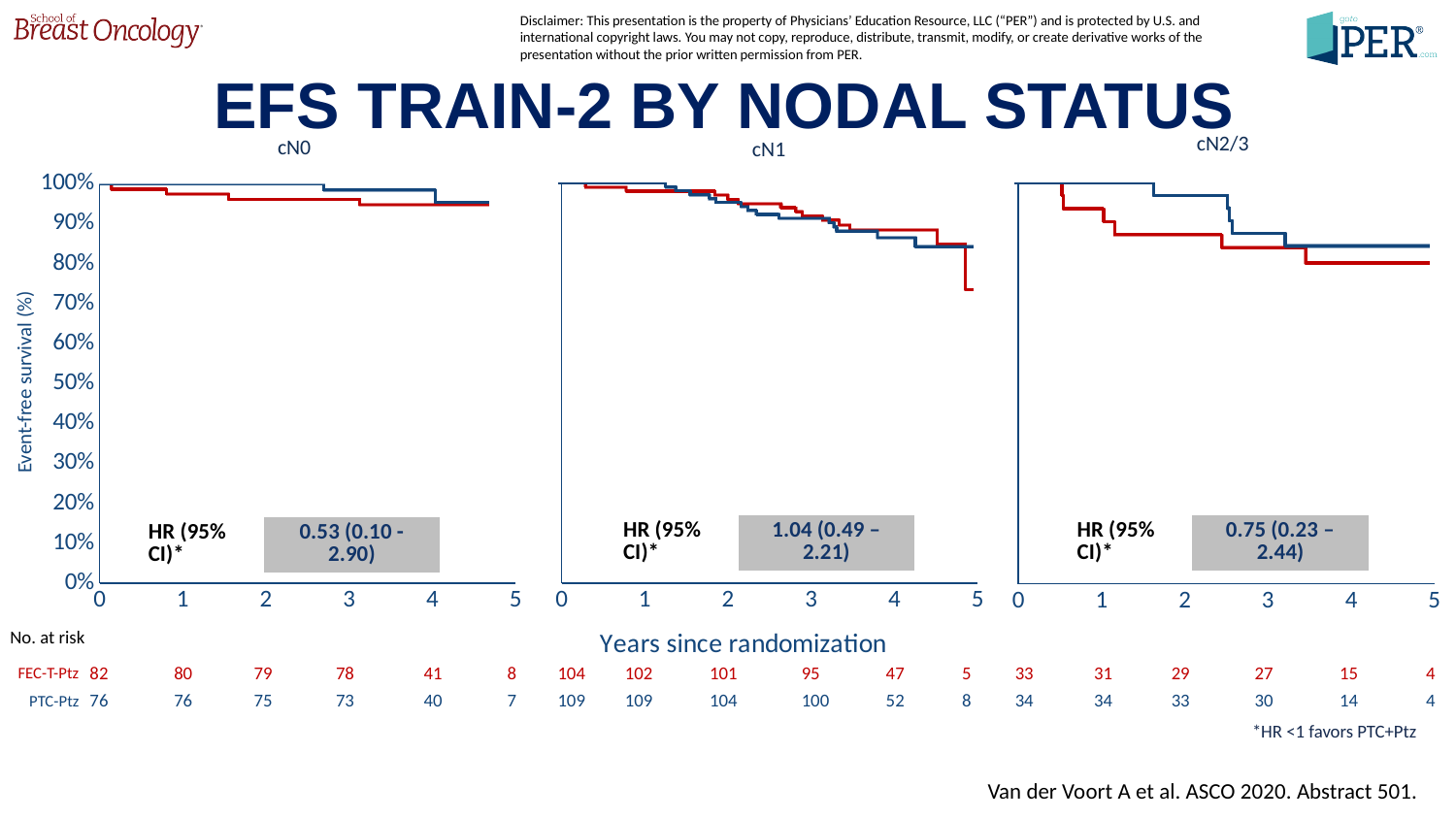
In the cN0 panel, is the event-free survival of the FEC-T-Ptz (red) curve at year 4 greater or less than 90%? greater In the cN0 panel, how many FEC-T-Ptz patients were at risk at year 0? 82 In the cN2/3 panel, what is the HR (95% CI) shown? 0.75 (0.23 – 2.44) In the cN1 panel, what is the difference between the number of PTC-Ptz and FEC-T-Ptz patients at risk at year 0? 5 How many panels (nodal status subgroups) are shown on the slide? 3 In the cN0 panel, what is the HR (95% CI) shown? 0.53 (0.10 - 2.90) What kind of chart is used in each of the three panels on the slide? Line chart (Kaplan-Meier survival curve) In the cN2/3 panel, how many FEC-T-Ptz patients were at risk at year 4? 15 In the cN1 panel, how many PTC-Ptz patients were at risk at year 3? 100 In the cN2/3 panel, do the survival curves rise or fall as years since randomization increase? fall In the cN1 panel, what is the HR (95% CI) shown? 1.04 (0.49 – 2.21) In the cN2/3 panel, is the event-free survival of the PTC-Ptz (blue) curve at year 4 greater or less than 90%? less